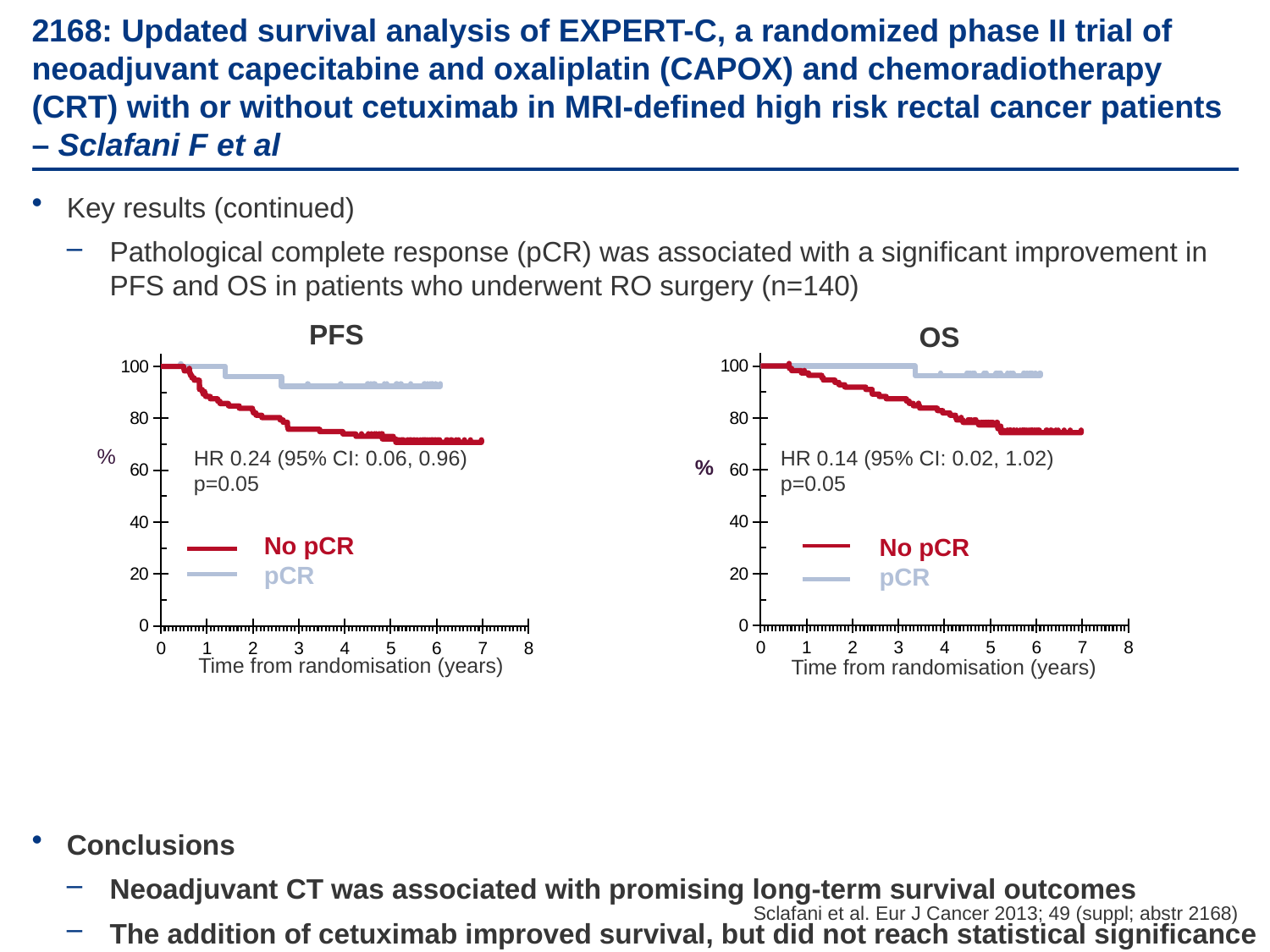
In the PFS chart, does the No pCR curve rise or fall as time from randomisation increases? Fall In the PFS chart, what hazard ratio is printed? HR 0.24 (95% CI: 0.06, 0.96) In the PFS chart, is the value for the No pCR curve at 6 years greater or less than 80? less What kind of chart is the PFS chart? Line chart (Kaplan-Meier survival curve) In the OS chart, is the value for the No pCR curve at 6 years greater or less than 80? less In the OS chart, what hazard ratio is printed? HR 0.14 (95% CI: 0.02, 1.02) In the PFS chart, which colour represents the No pCR series? Red What is the label of the x axis on the OS chart? Time from randomisation (years) In the PFS chart, is the value for the pCR curve at 6 years greater or less than 80? greater In the PFS chart, what p-value is printed? p=0.05 In the OS chart, which curve is higher at 5 years, No pCR or pCR? pCR How many series does the legend of the OS chart list? 2